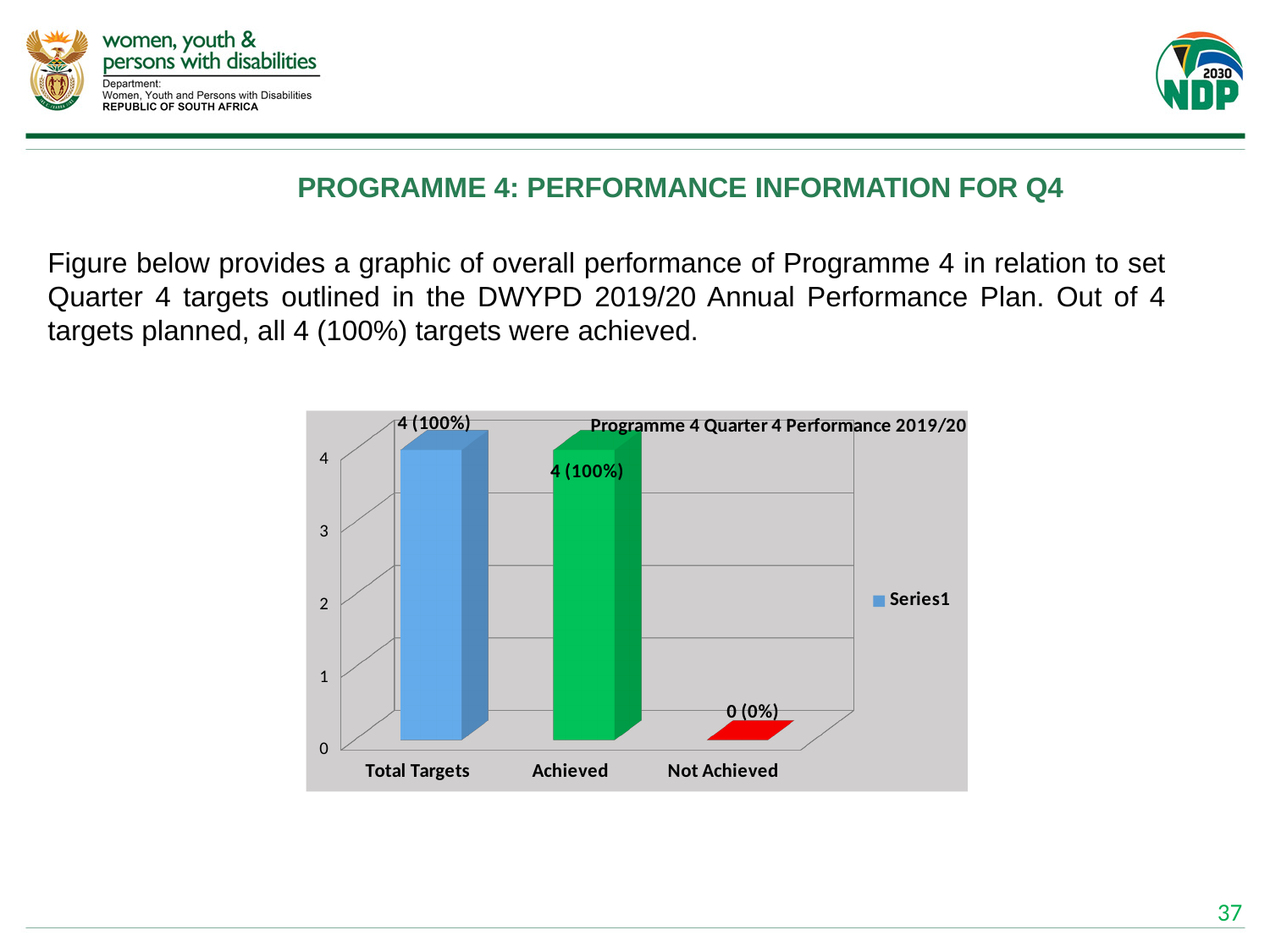
What kind of chart is shown? bar chart Which is larger, the value for Achieved or the value for Not Achieved? Achieved What is the title of the chart? Programme 4 Quarter 4 Performance 2019/20 What is the value shown for Achieved? 4 (100%) How many series does the legend list? 1 What colour is the Not Achieved bar? red Is the value for Total Targets greater or less than 2? greater What is the value shown for Total Targets? 4 (100%) Which category has the lowest value? Not Achieved What is the difference between the Achieved value and the Not Achieved value? 4 What is the value shown for Not Achieved? 0 (0%) How many categories are shown on the x axis? 3